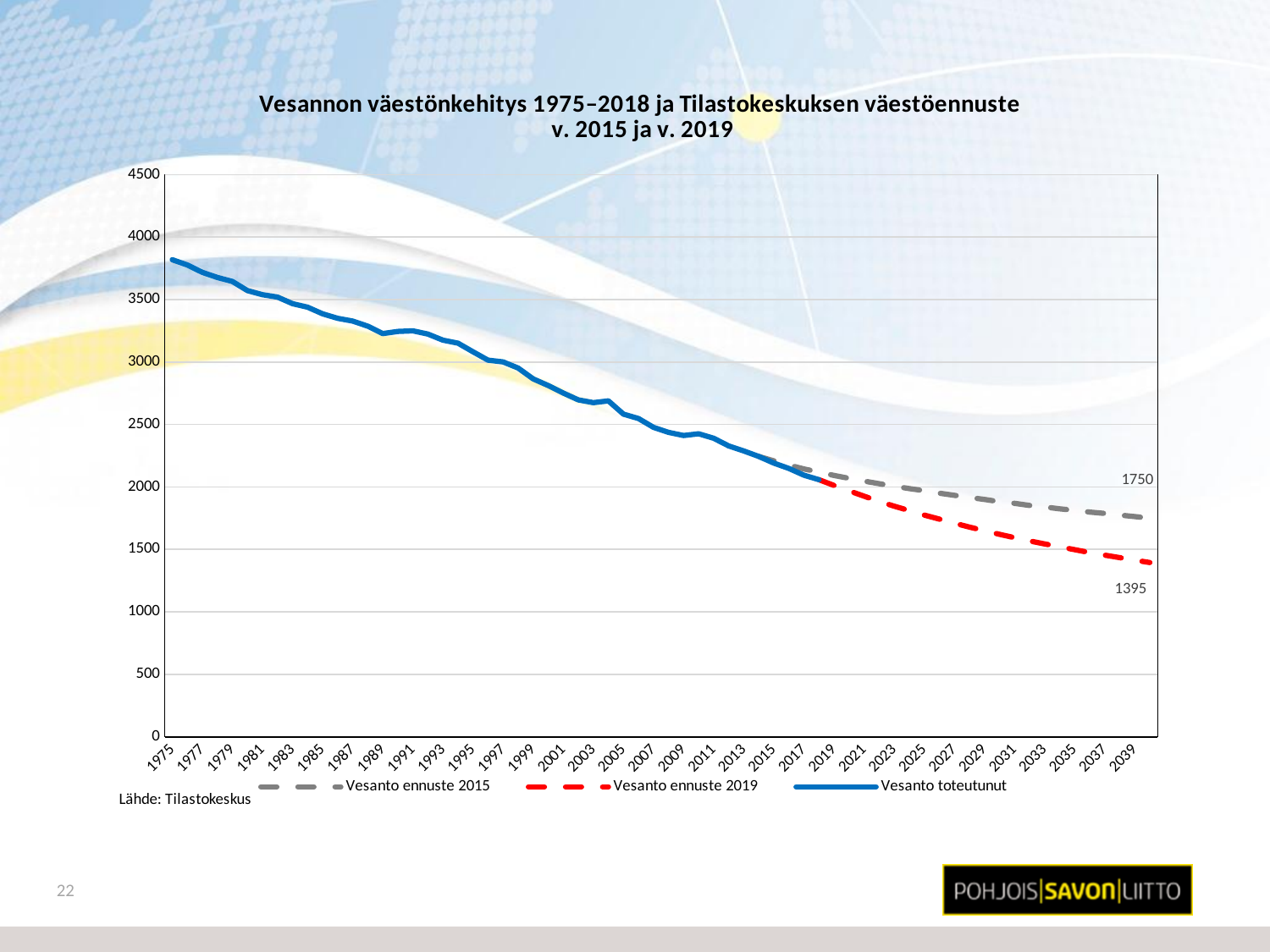
Is the value of Vesanto toteutunut in 1999 greater or less than 2500? greater What is the difference between the labelled end values of Vesanto ennuste 2015 (1750) and Vesanto ennuste 2019 (1395)? 355 Does the Vesanto toteutunut series rise or fall from 1975 to 2018? fall How many series does the legend list? 3 What colour is the Vesanto toteutunut line? blue Is the value of Vesanto toteutunut in 1975 greater or less than 3500? greater What is the labelled end value of the Vesanto ennuste 2015 series? 1750 What kind of chart is shown on the slide? line chart What is the labelled end value of the Vesanto ennuste 2019 series? 1395 Is the value of Vesanto toteutunut in 2017 greater or less than 2500? less Which forecast series ends at a higher value, Vesanto ennuste 2015 or Vesanto ennuste 2019? Vesanto ennuste 2015 What is the title of the chart? Vesannon väestönkehitys 1975–2018 ja Tilastokeskuksen väestöennuste v. 2015 ja v. 2019